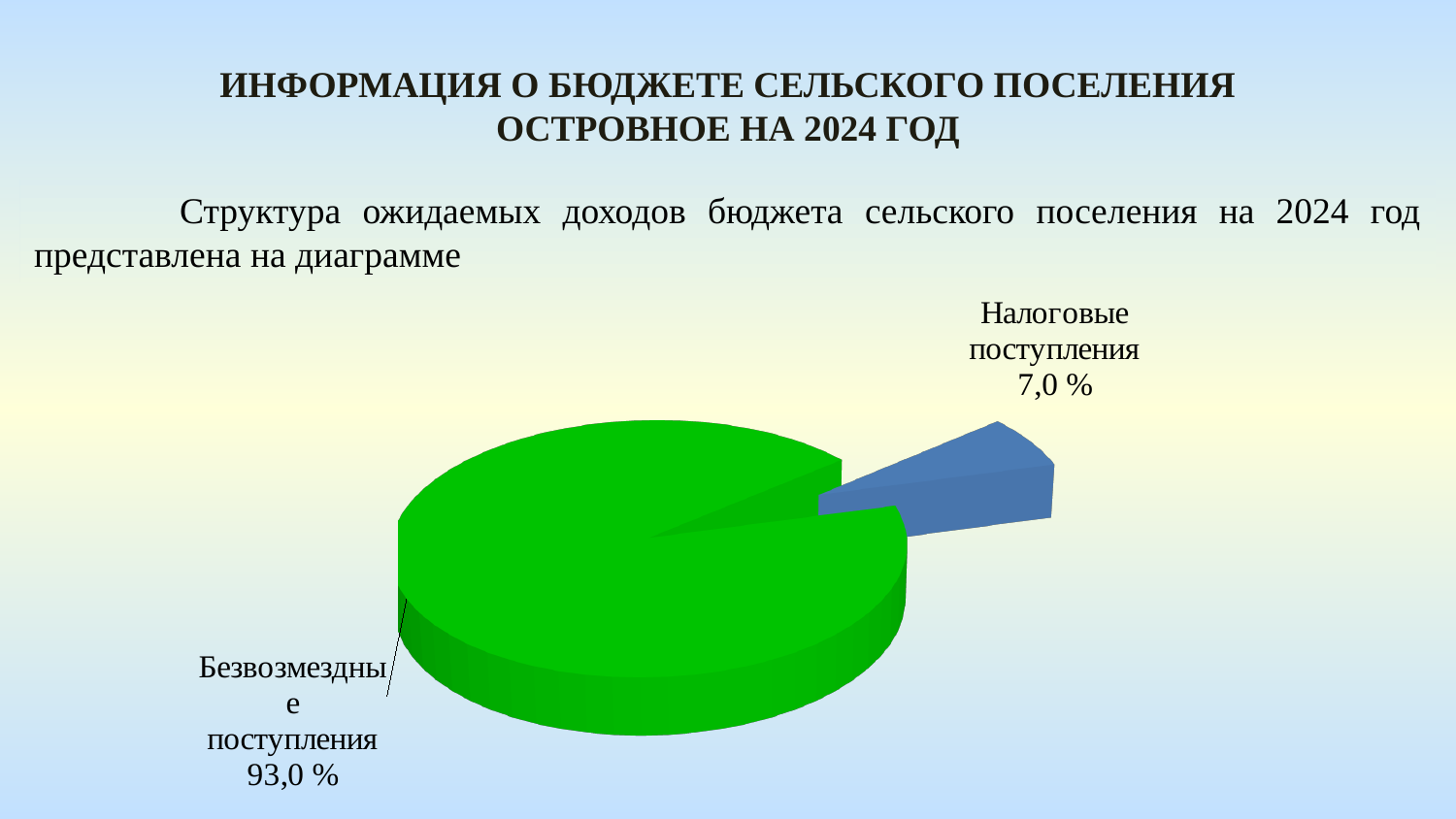
What share of the pie is labelled Безвозмездные поступления? 93,0 % Which is larger: Налоговые поступления or Безвозмездные поступления? Безвозмездные поступления What colour is the slice for Налоговые поступления? blue Which slice of the pie is the smallest? Налоговые поступления What kind of chart is shown on the slide? pie chart What is the total of the two slices shown on the pie chart? 100,0 % What is the difference in percentage points between Безвозмездные поступления and Налоговые поступления? 86,0 % Which slice of the pie is the largest? Безвозмездные поступления How many slices does the pie chart have? 2 What colour is the slice for Безвозмездные поступления? green What share of the pie is labelled Налоговые поступления? 7,0 %